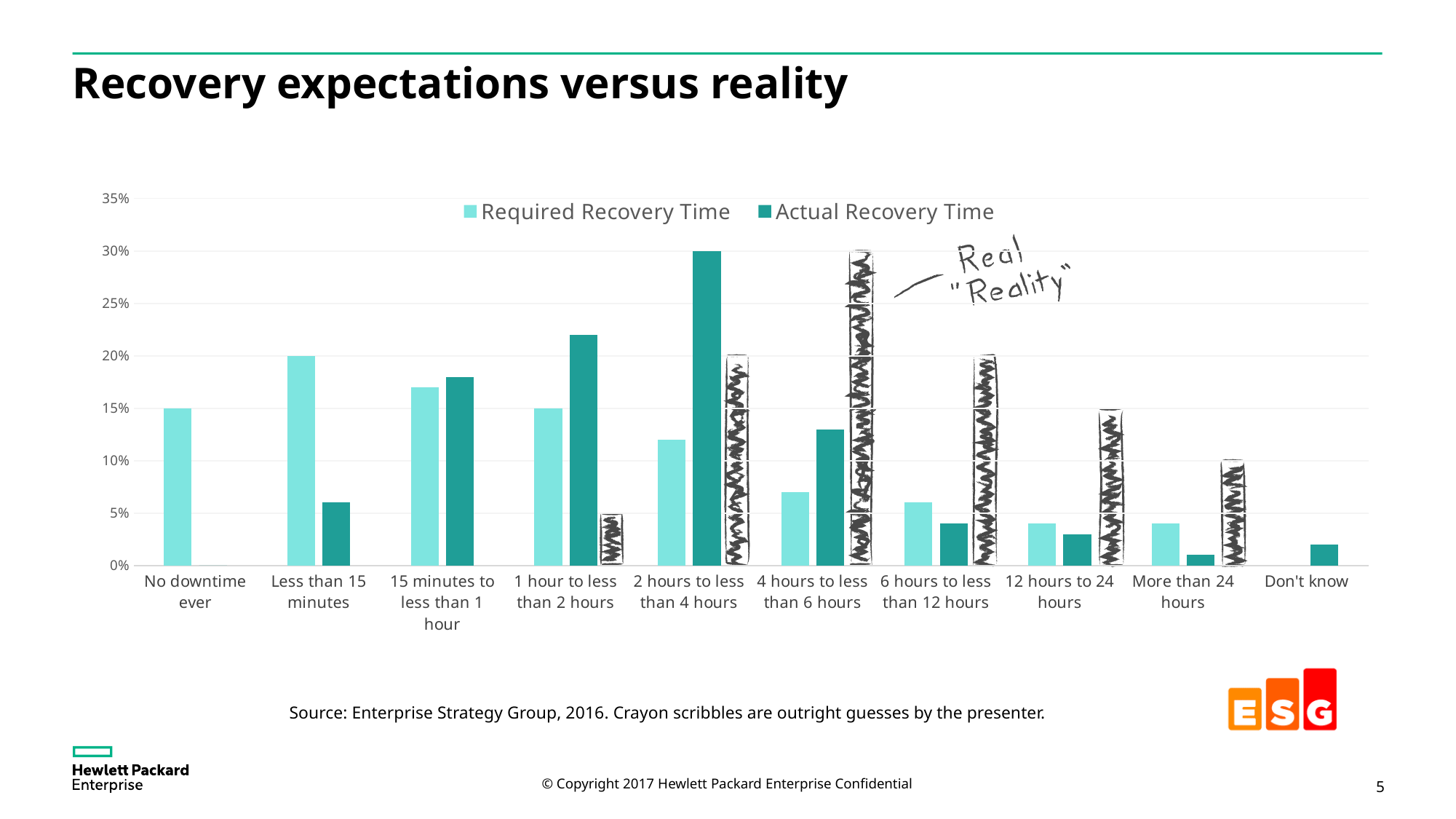
For "Less than 15 minutes", which is larger: Required Recovery Time or Actual Recovery Time? Required Recovery Time How many series does the legend list? 2 Which category has the highest Actual Recovery Time value? 2 hours to less than 4 hours Is the Actual Recovery Time value for "1 hour to less than 2 hours" greater or less than 20%? greater What is the Required Recovery Time value for "Less than 15 minutes"? 20% Is the Actual Recovery Time value for "Less than 15 minutes" greater or less than 10%? less What is the difference between the Required Recovery Time values for "Less than 15 minutes" and "No downtime ever"? 5 percentage points What is the Actual Recovery Time value for "2 hours to less than 4 hours"? 30% Which category has the highest Required Recovery Time value? Less than 15 minutes How many categories are shown on the x axis? 10 What kind of chart is shown on the slide? Bar chart What is the Required Recovery Time value for "No downtime ever"? 15%